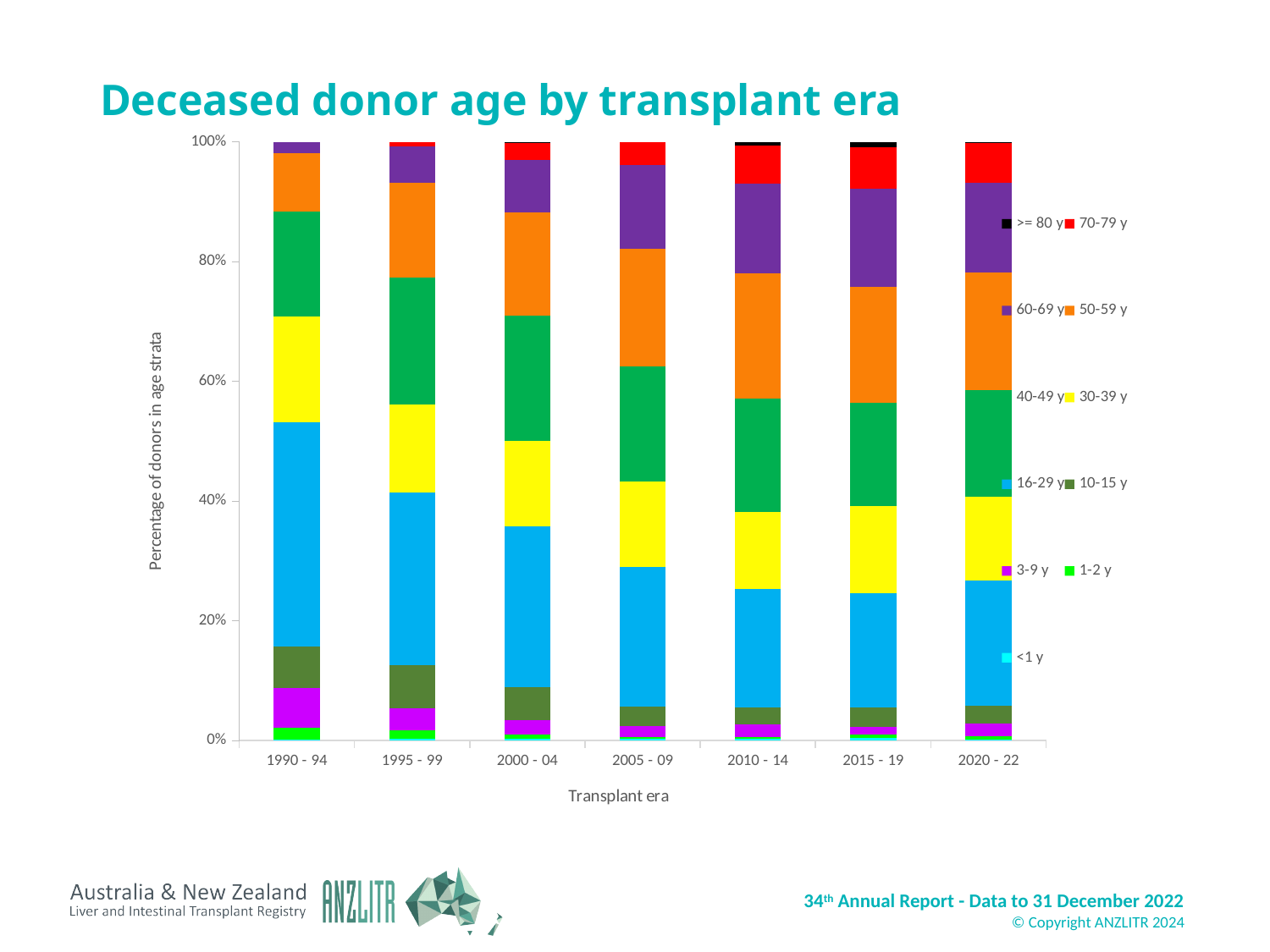
Is the 16-29 y segment larger in 1990 - 94 or in 2020 - 22? 1990 - 94 In the 2010 - 14 bar, is the cumulative share up to the top of the 30-39 y segment greater or less than 40%? less How many age strata series does the legend list? 11 In the 1990 - 94 bar, is the cumulative share up to the top of the 16-29 y segment greater or less than 50%? greater Does the share of 16-29 y donors rise or fall across the transplant eras from 1990 - 94 to 2020 - 22? Fall In the 2020 - 22 bar, is the cumulative share up to the top of the 50-59 y segment greater or less than 80%? less How many transplant eras are shown on the x axis? 7 Is the 50-59 y segment larger in 2020 - 22 or in 1990 - 94? 2020 - 22 Which transplant era has the largest 16-29 y segment? 1990 - 94 What is the label of the y axis? Percentage of donors in age strata What kind of chart is shown on the slide? Stacked bar chart What is the title of the chart? Deceased donor age by transplant era